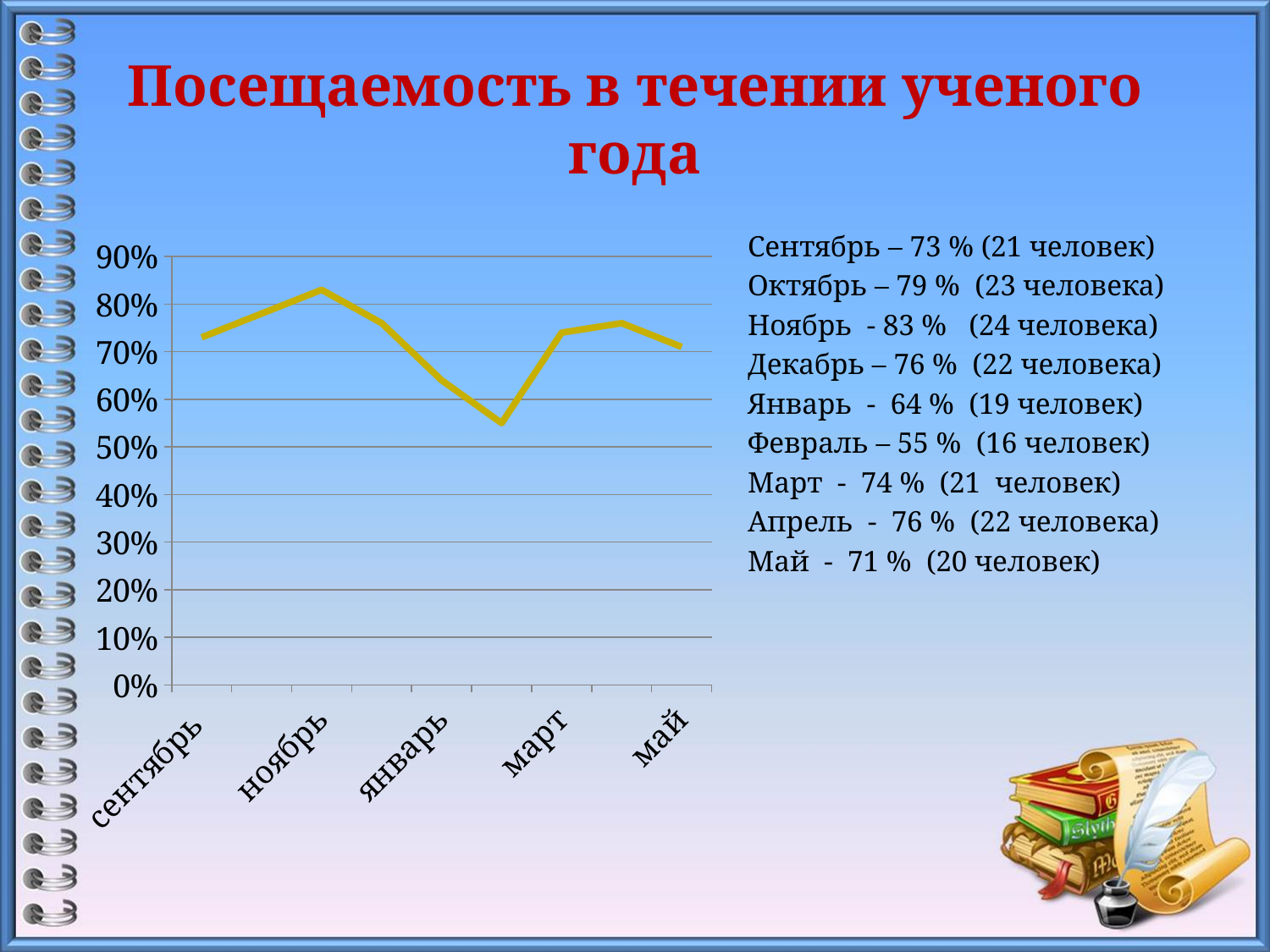
What is the difference between the attendance in ноябрь (83 %) and февраль (55 %)? 28 % Which month has the lowest attendance? Февраль What is the attendance value for май (May)? 71 % What kind of chart is shown on the slide? line chart Does the line rise or fall between ноябрь and февраль? fall Is the value for ноябрь greater or less than 80%? greater Is the value for февраль greater or less than 60%? less Which month has the highest attendance? Ноябрь Which is larger, the attendance in сентябрь or in январь? сентябрь What is the attendance value for февраль (February)? 55 % How many months are plotted on the line? 9 What is the attendance value for ноябрь (November)? 83 %